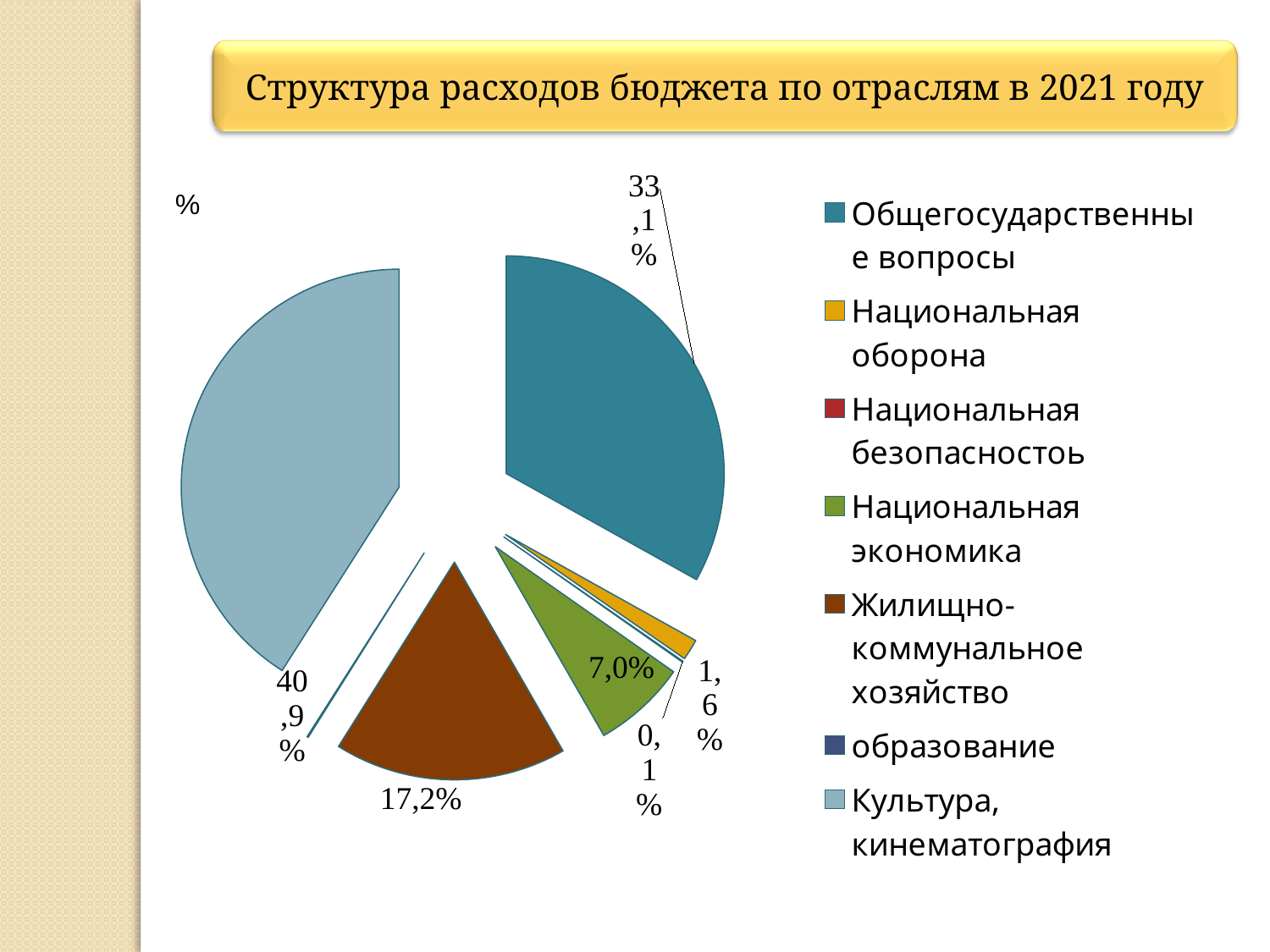
What is the share for Жилищно-коммунальное хозяйство? 17,2% How many categories does the legend list? 7 What is the share for Национальная оборона? 1,6% What is the share for Общегосударственные вопросы? 33,1% What kind of chart is shown on the slide? Pie chart What is the difference between the shares of Культура, кинематография and Общегосударственные вопросы? 7,8% What is the share for Культура, кинематография? 40,9% What is the share for Национальная безопасность? 0,1% What is the title of the slide? Структура расходов бюджета по отраслям в 2021 году What is the share for Национальная экономика? 7,0% Which category has the largest slice of the pie? Культура, кинематография Which is larger: Общегосударственные вопросы or Жилищно-коммунальное хозяйство? Общегосударственные вопросы